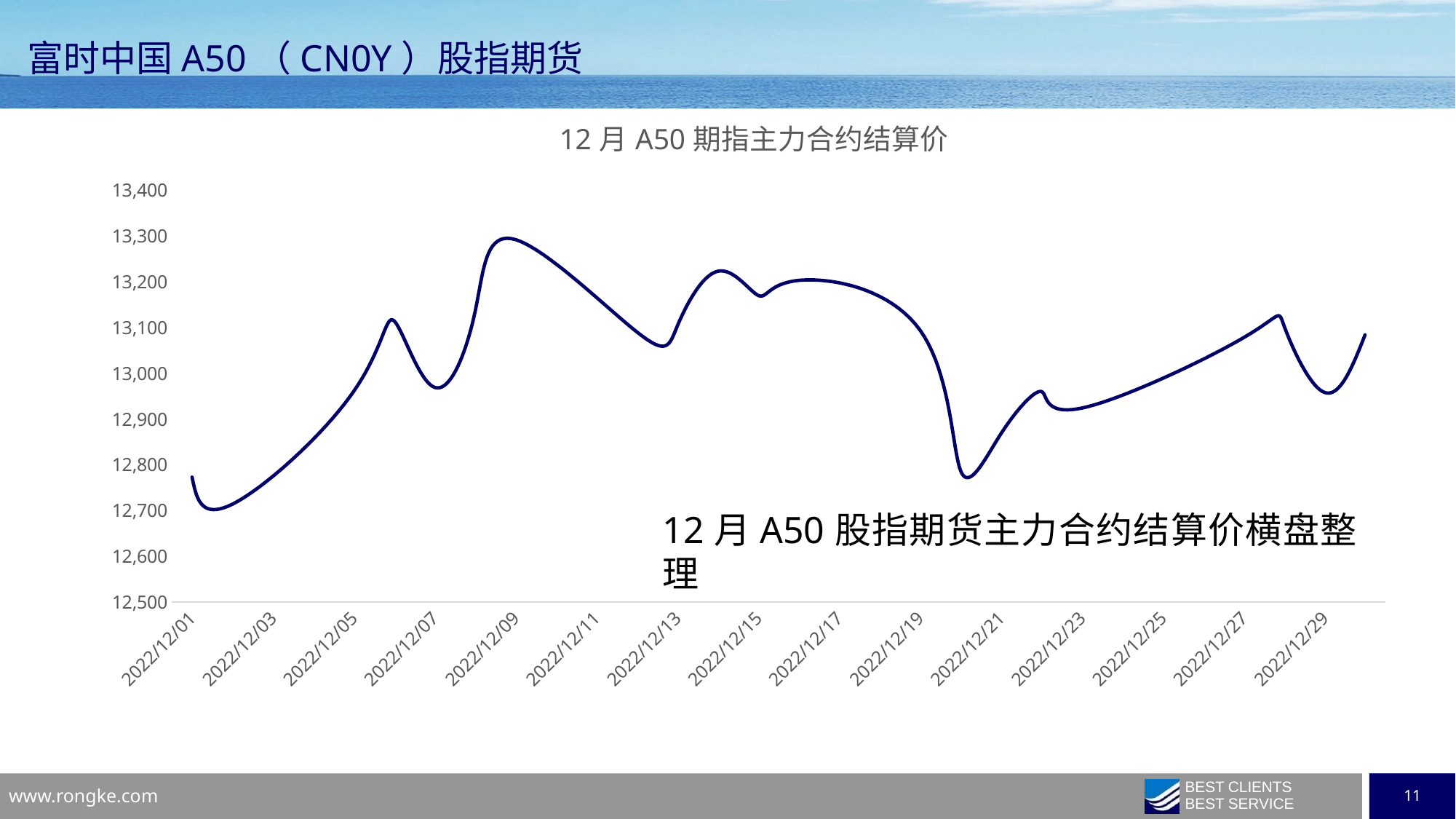
Is the value at 2022/12/23 greater or less than 13,000? less How many date labels are shown on the x axis of the chart? 15 Is the value at 2022/12/13 greater or less than 13,000? greater Does the line rise or fall between 2022/12/01 and 2022/12/09? rise Is the value at 2022/12/09 greater or less than 13,200? greater Which is larger, the value at 2022/12/09 or the value at 2022/12/21? 2022/12/09 What is the title of the chart? 12 月 A50 期指主力合约结算价 What kind of chart is shown on the slide? line chart What is the highest value shown on the y axis? 13,400 Around which x-axis date does the line reach its highest point? 2022/12/09